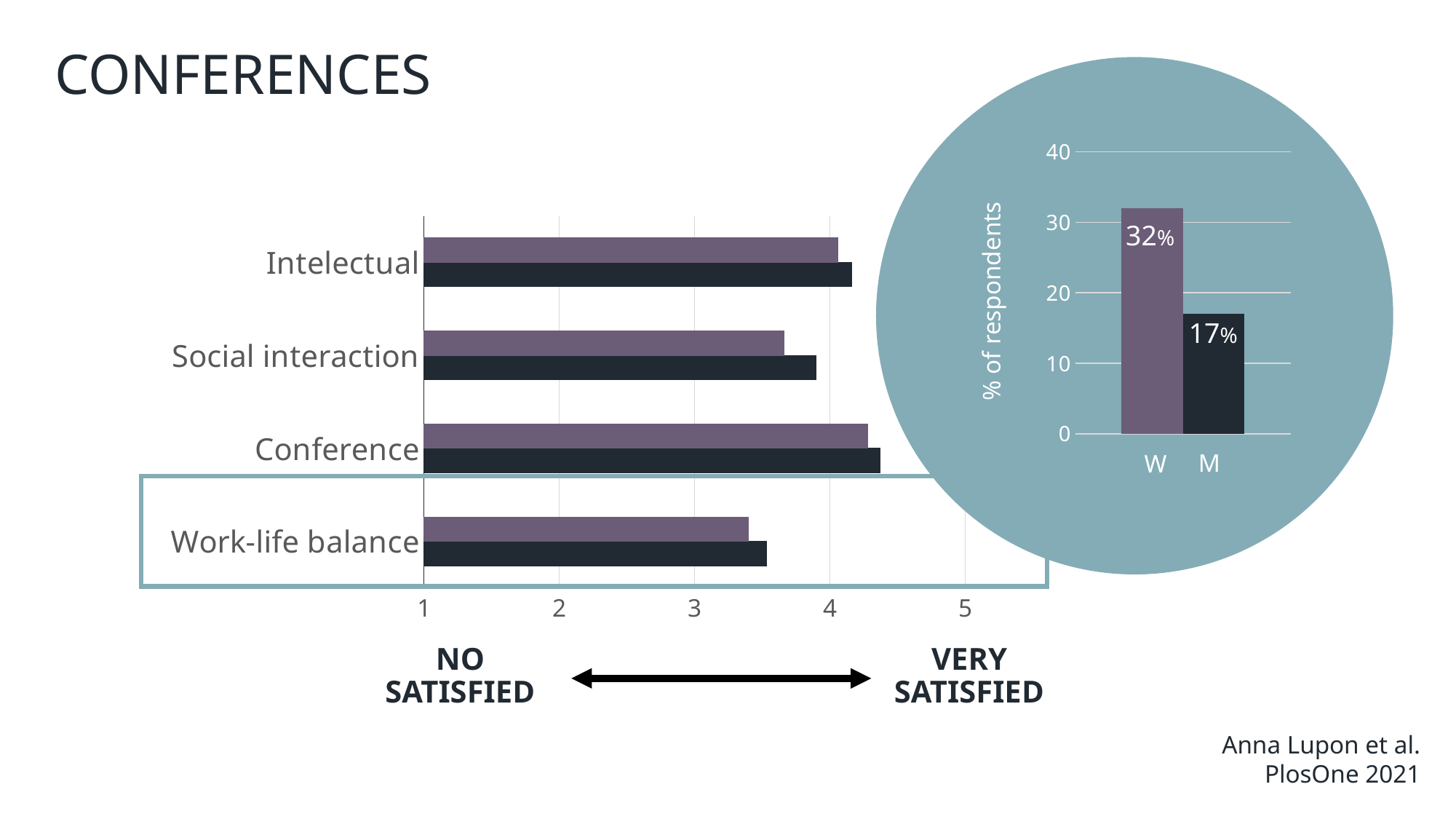
In the main chart on the left, is the purple bar for Work-life balance greater or less than 4? less In the inset chart on the right, what is the y-axis label? % of respondents In the main chart on the left, which category has the lowest satisfaction values? Work-life balance How many categories are shown in the main satisfaction bar chart on the left? 4 In the inset chart on the right, what is the value for M? 17% In the inset chart on the right, what is the difference between the W and M values? 15% In the main chart on the left, is the purple bar for Social interaction greater or less than 3? greater In the main chart on the left, is the dark bar for Conference greater or less than 4? greater In the main chart on the left, which category has the highest satisfaction values? Conference In the inset chart on the right, what is the value for W? 32% What kind of chart is the main chart on the left? bar chart In the inset chart on the right, which bar is higher, W or M? W